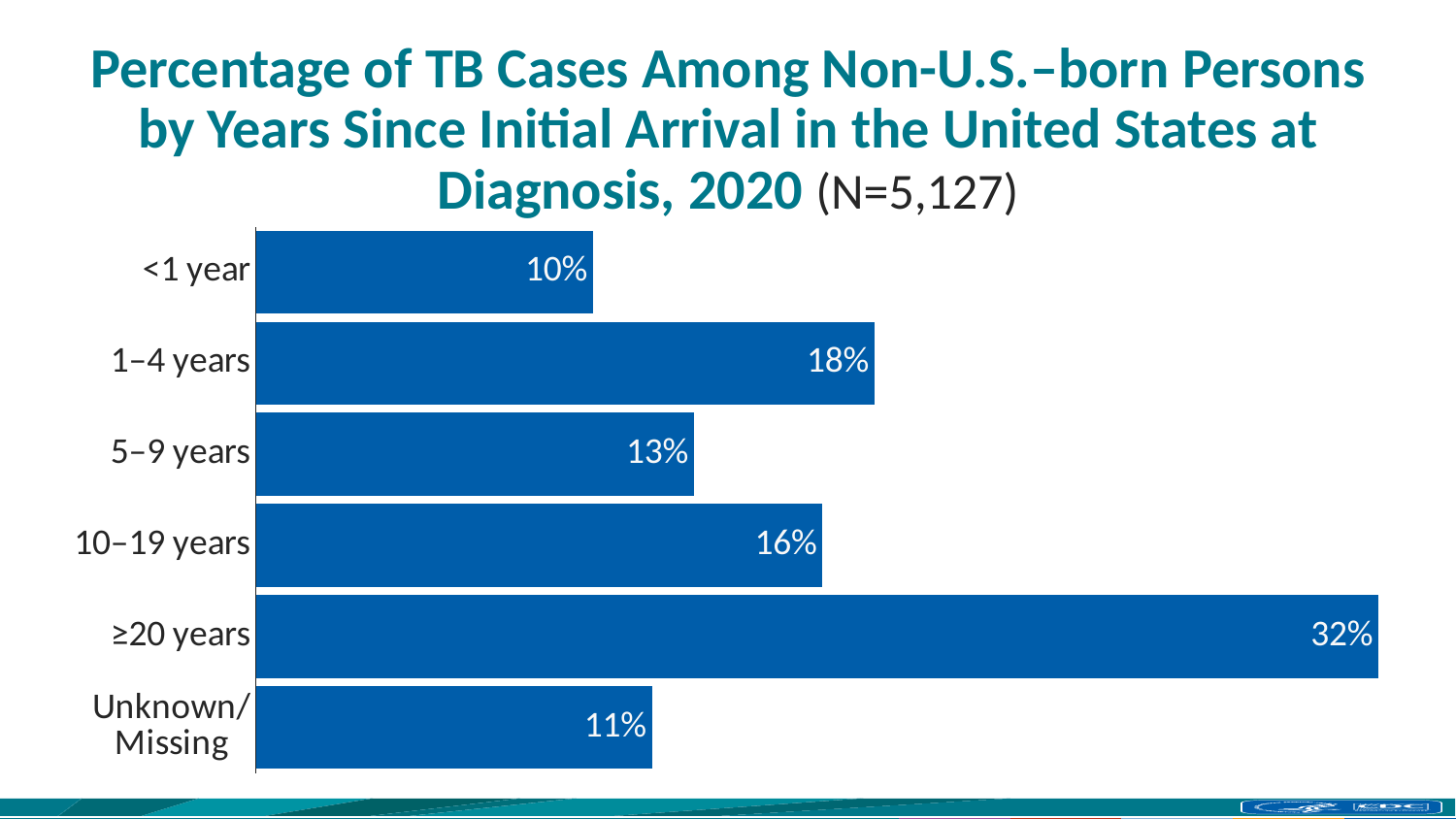
What percentage is shown for the 5–9 years category? 13% Which is larger, the value for 1–4 years or the value for 5–9 years? 1–4 years What kind of chart is shown on the slide? Bar chart What percentage of TB cases among non-U.S.-born persons were diagnosed less than 1 year after initial arrival? 10% What is the total number of cases (N) stated in the chart title? 5,127 What is the difference in percentage points between the ≥20 years and 10–19 years categories? 16 How many categories are shown in the chart? 6 Which category has the lowest percentage of TB cases? <1 year What year does the chart title say the data are for? 2020 What is the value for the Unknown/Missing category? 11% Which category has the highest percentage of TB cases? ≥20 years What is the value shown for the 1–4 years category? 18%